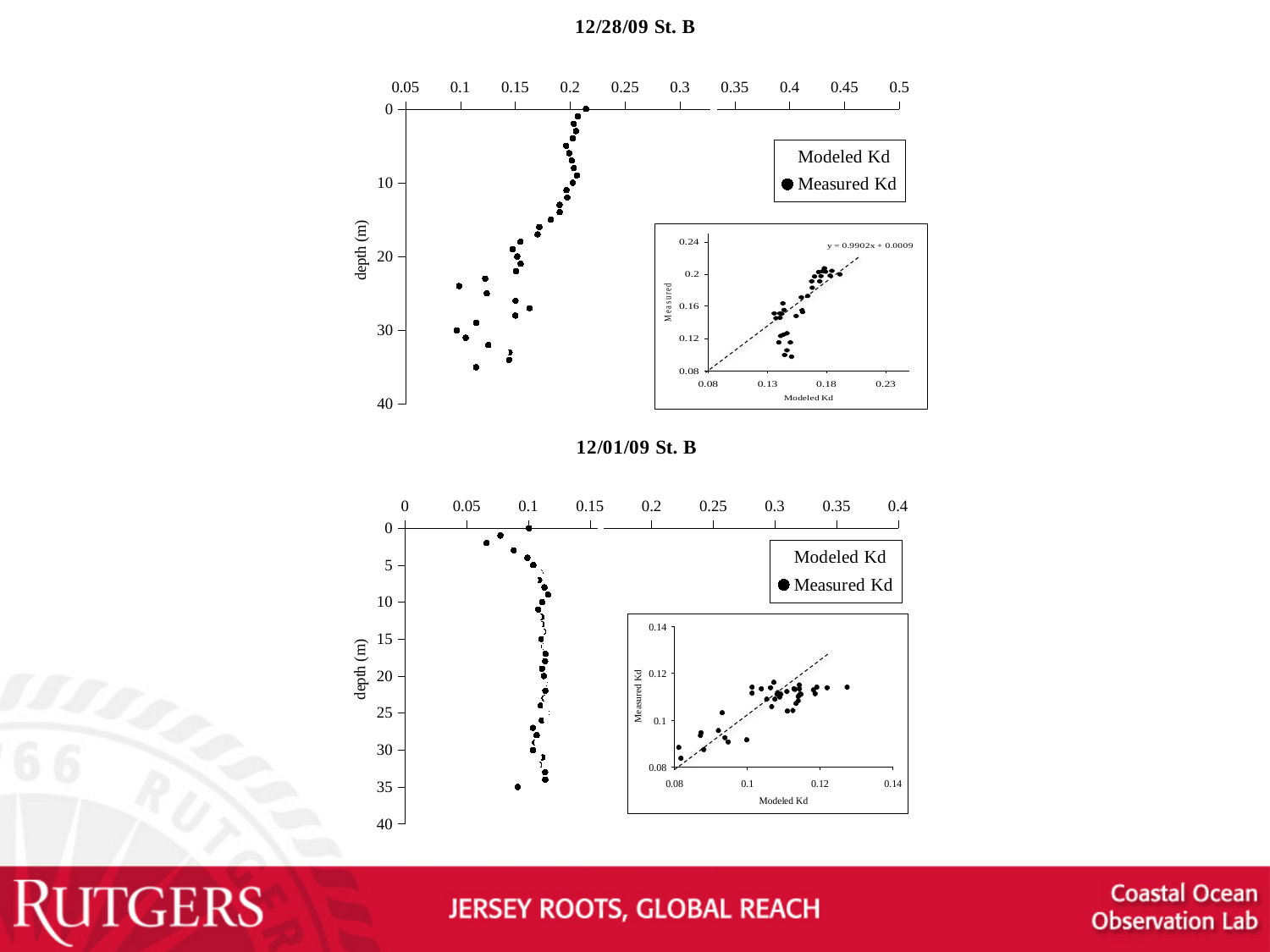
How many series does the legend of the 12/01/09 St. B chart list? 2 What kind of chart is the top chart titled 12/28/09 St. B? scatter chart In the 12/28/09 St. B chart, is the measured Kd value at depth 0 m greater or less than 0.15? greater How many series does the legend of the 12/28/09 St. B chart list? 2 What are the two legend entries shown on the 12/01/09 St. B chart? Modeled Kd, Measured Kd In the 12/28/09 St. B chart, as depth increases from 0 m to 35 m, do the measured Kd values generally increase or decrease? decrease In the 12/01/09 St. B chart, is the measured Kd value at depth 35 m greater or less than 0.15? less In the 12/28/09 St. B chart, is the measured Kd value at depth 35 m greater or less than 0.15? less In the 12/28/09 St. B chart, which is larger: the measured Kd at depth 0 m or at depth 30 m? depth 0 m What regression equation is printed on the inset scatter plot of the 12/28/09 St. B chart? y = 0.9902x + 0.0009